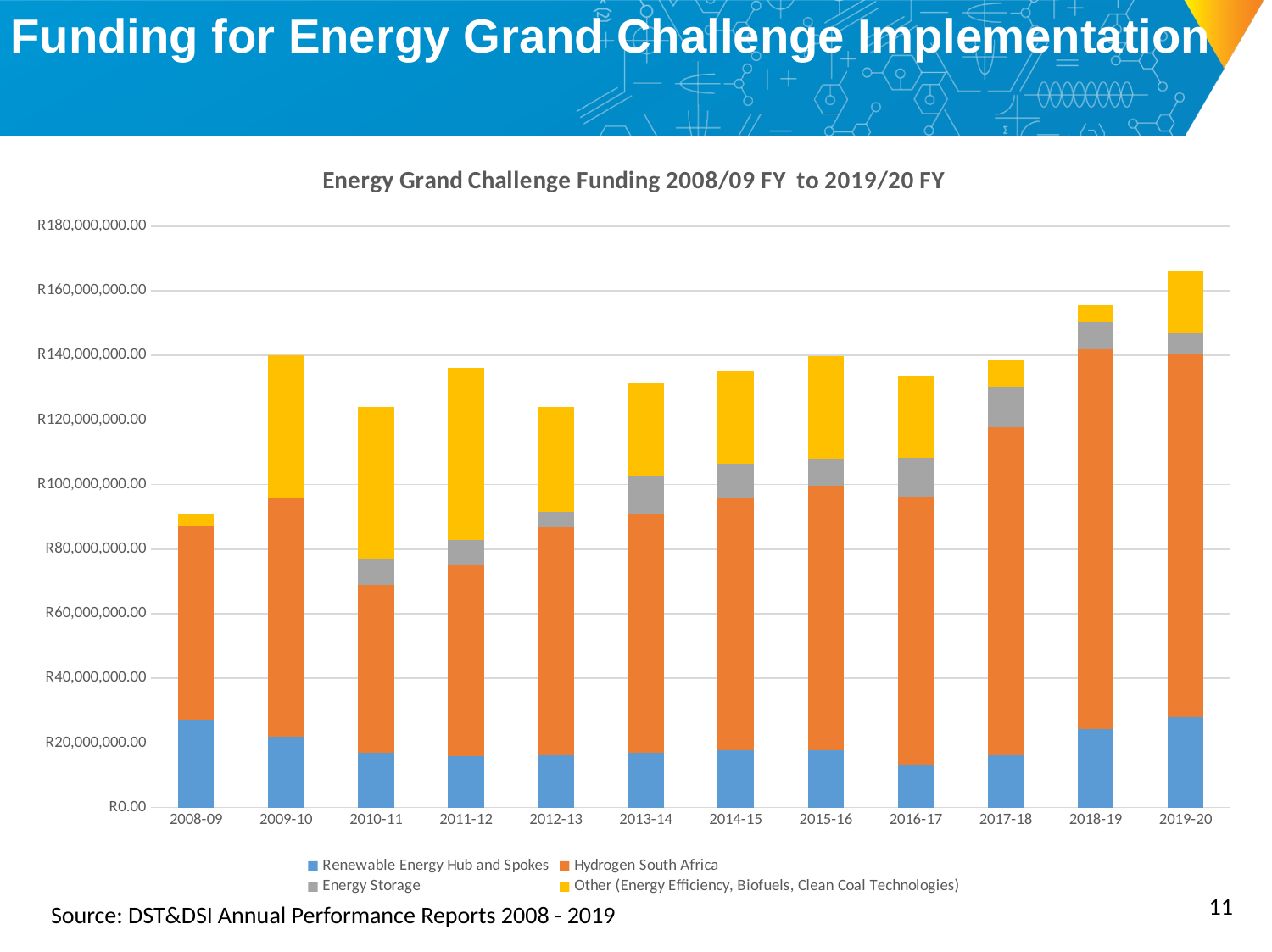
Which year has the larger total funding, 2009-10 or 2010-11? 2009-10 Which financial year has the highest total funding? 2019-20 Which financial year has the lowest total funding? 2008-09 Is the Renewable Energy Hub and Spokes value for 2016-17 greater or less than R20,000,000.00? less Is the total funding for 2019-20 greater or less than R160,000,000.00? greater How many series does the chart's legend list? 4 What kind of chart is shown on the slide? Stacked bar chart What is the title of the chart? Energy Grand Challenge Funding 2008/09 FY to 2019/20 FY Which colour represents Energy Storage in the chart? Grey Is the total funding for 2008-09 greater or less than R100,000,000.00? less How many financial years are shown on the x axis of the chart? 12 Does the total funding rise or fall from 2016-17 to 2019-20? rise